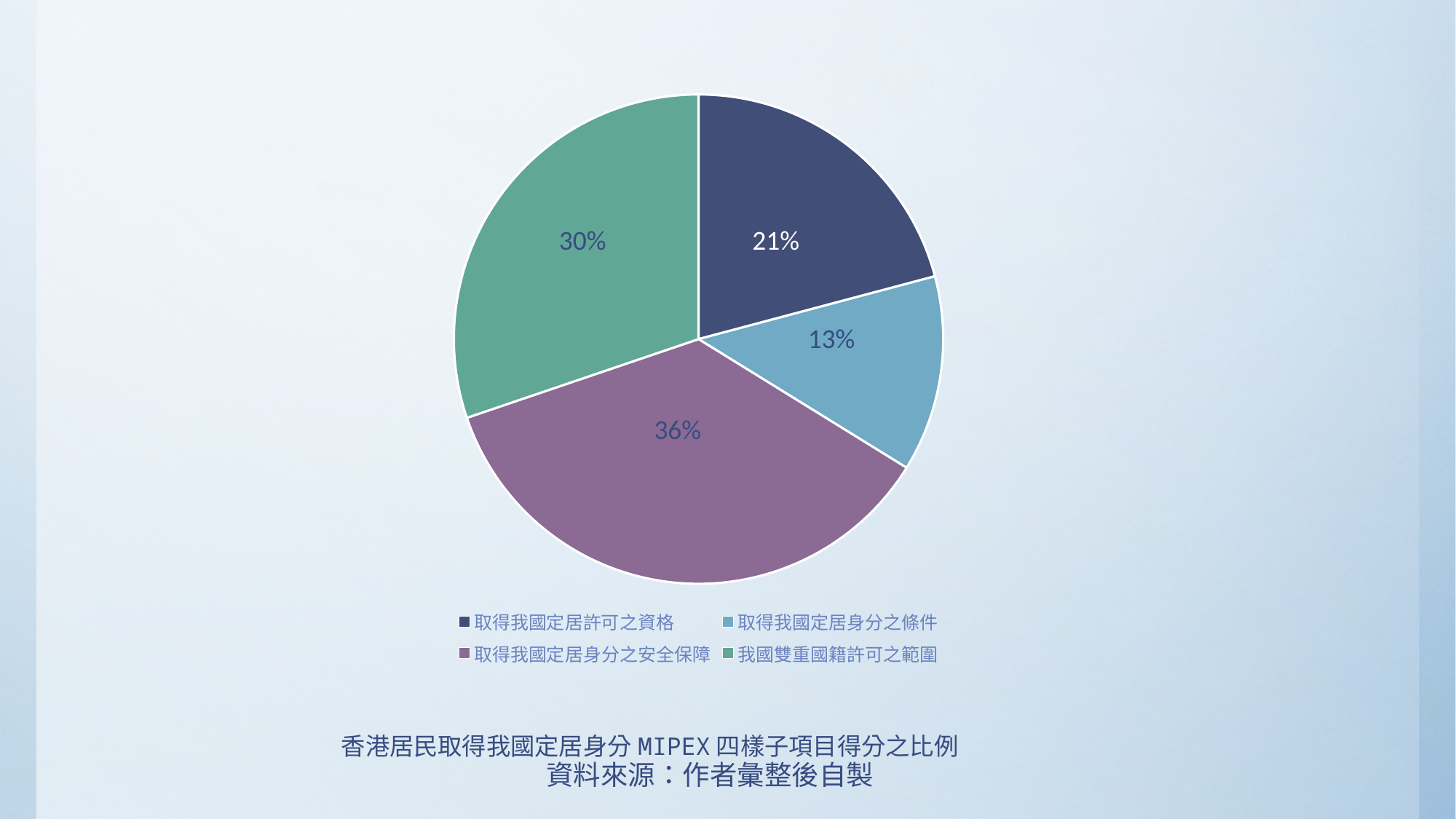
How many entries does the legend list? 4 How many slices does the pie chart have? 4 What is the difference in percentage points between 取得我國定居身分之安全保障 and 取得我國定居身分之條件? 23% What share of the pie does 我國雙重國籍許可之範圍 have? 30% What colour is the slice for 取得我國定居身分之安全保障? purple What share of the pie does 取得我國定居身分之安全保障 have? 36% Which category has the smallest slice of the pie? 取得我國定居身分之條件 What share of the pie does 取得我國定居身分之條件 have? 13% Which category has the largest slice of the pie? 取得我國定居身分之安全保障 What kind of chart is shown on the slide? pie chart Which is larger: the slice for 我國雙重國籍許可之範圍 or the slice for 取得我國定居許可之資格? 我國雙重國籍許可之範圍